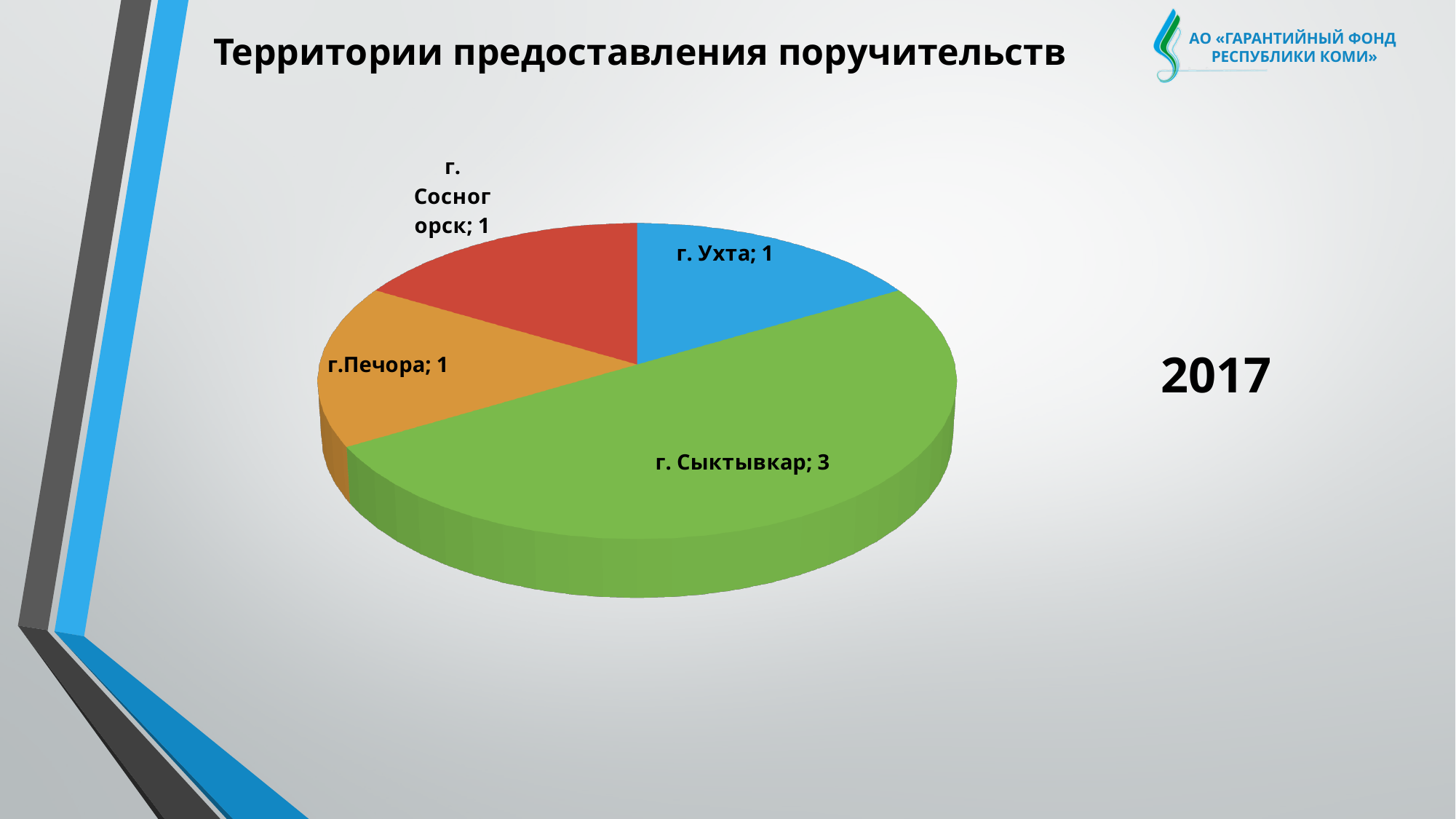
What type of chart is shown on the slide? Pie chart What is the value for г. Сыктывкар? 3 What is the value for г. Сосногорск? 1 What is the value for г. Ухта? 1 What share of the pie does г. Сыктывкар represent? 50% Which category has the largest slice of the pie? г. Сыктывкар How many categories are shown in the pie chart? 4 What year is shown next to the chart? 2017 What is the value for г.Печора? 1 Which is larger, the value for г. Сыктывкар or the value for г.Печора? г. Сыктывкар What is the difference between the values for г. Сыктывкар and г. Ухта? 2 What is the title of the chart on the slide? Территории предоставления поручительств